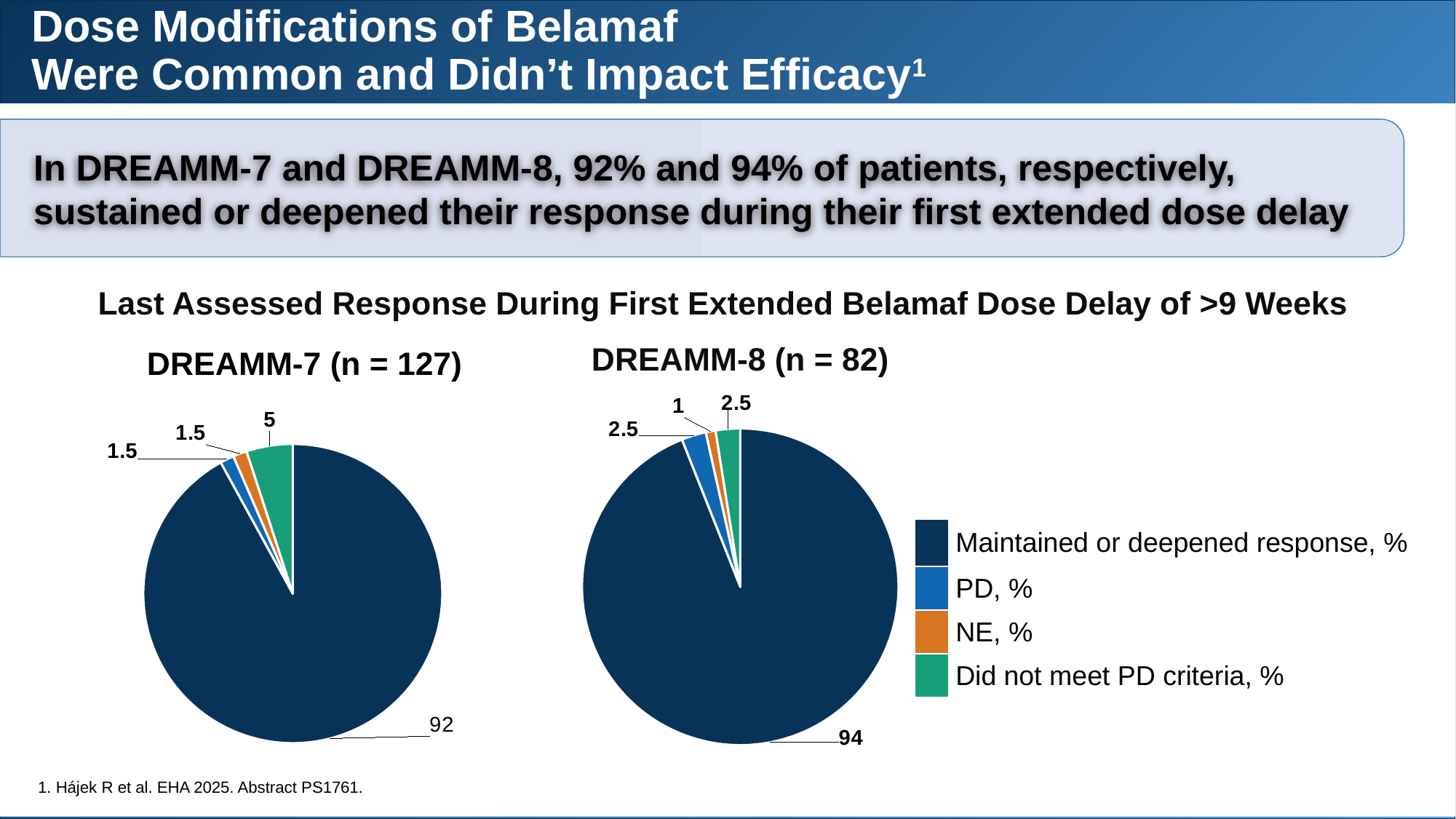
In the DREAMM-8 (n = 82) pie chart, what is the value for NE? 1 What is the difference between the Maintained or deepened response values in the DREAMM-8 and DREAMM-7 pie charts? 2 How many slices does the DREAMM-7 (n = 127) pie chart have? 4 Which colour represents PD in the legend of the pie charts? Blue In the DREAMM-7 (n = 127) pie chart, what is the value for Maintained or deepened response? 92 In the DREAMM-7 (n = 127) pie chart, which category has the largest slice? Maintained or deepened response What type of chart is used to show the DREAMM-7 and DREAMM-8 data? Pie chart Is the Did not meet PD criteria value larger in the DREAMM-7 pie chart or the DREAMM-8 pie chart? DREAMM-7 In the DREAMM-8 (n = 82) pie chart, what is the value for Maintained or deepened response? 94 In the DREAMM-8 (n = 82) pie chart, which category has the smallest slice? NE In the DREAMM-7 (n = 127) pie chart, what is the value for Did not meet PD criteria? 5 In the DREAMM-8 (n = 82) pie chart, what is the value for PD? 2.5